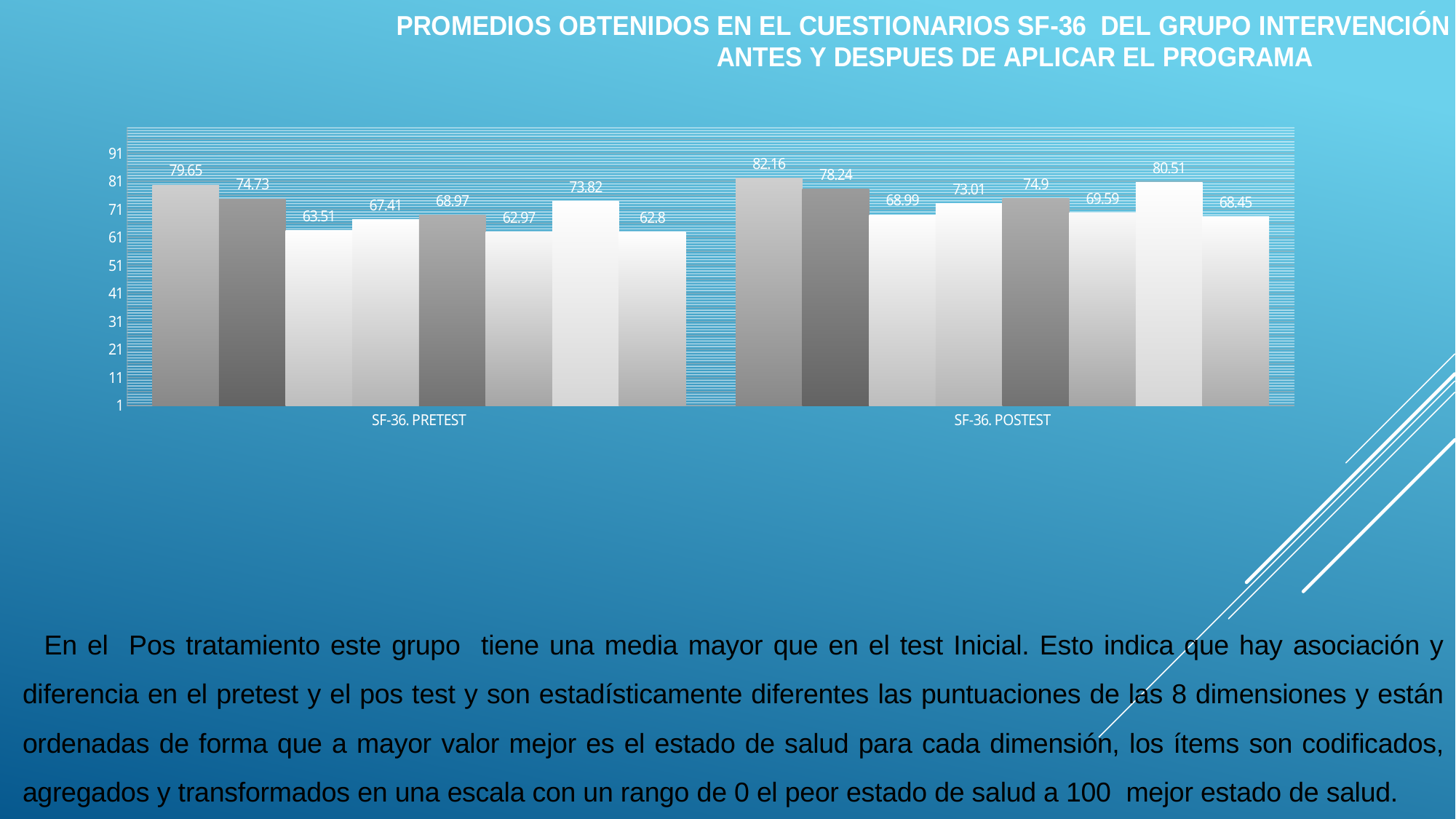
How many bars are plotted for the SF-36. PRETEST category? 8 What is the value of the tallest bar in the SF-36. POSTEST group? 82.16 What is the difference between the first bar of SF-36. POSTEST (82.16) and the first bar of SF-36. PRETEST (79.65)? 2.51 What is the value of the tallest bar in the SF-36. PRETEST group? 79.65 What kind of chart is shown on the slide? bar chart What is the value of the shortest bar in the SF-36. PRETEST group? 62.8 How many categories are shown on the x axis of the chart? 2 Is the value of the last bar in the SF-36. PRETEST group (62.8) greater or less than 71? less What is the title of the chart? PROMEDIOS OBTENIDOS EN EL CUESTIONARIOS SF-36 DEL GRUPO INTERVENCIÓN ANTES Y DESPUES DE APLICAR EL PROGRAMA What is the value of the first (leftmost) bar in the SF-36. POSTEST group? 82.16 Which is larger: the tallest bar in SF-36. PRETEST or the tallest bar in SF-36. POSTEST? SF-36. POSTEST What is the value of the shortest bar in the SF-36. POSTEST group? 68.45